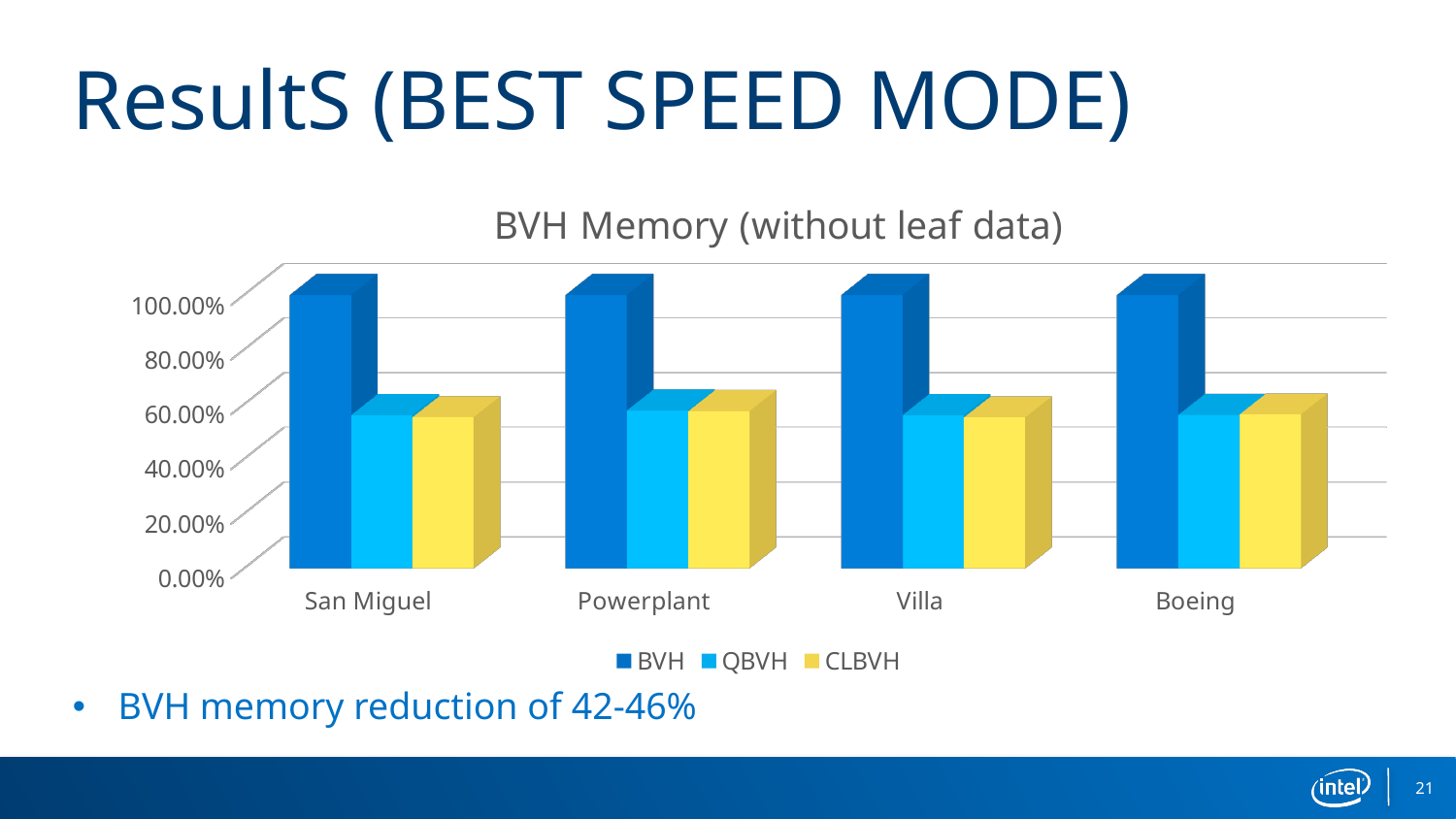
Is the CLBVH value for Powerplant greater or less than 40.00%? greater Which is larger for Powerplant, the BVH value or the QBVH value? BVH Is the QBVH value for Villa greater or less than 80.00%? less Which series has the highest value for Boeing? BVH How many categories are shown on the x axis? 4 Which series has the highest value for San Miguel? BVH What are the names of the series listed in the legend? BVH, QBVH, CLBVH What is the title of the chart? BVH Memory (without leaf data) How many series does the legend list? 3 What type of chart is shown on the slide? bar chart Which is larger for Villa, the CLBVH value or the BVH value? BVH Is the QBVH value for San Miguel greater or less than 80.00%? less